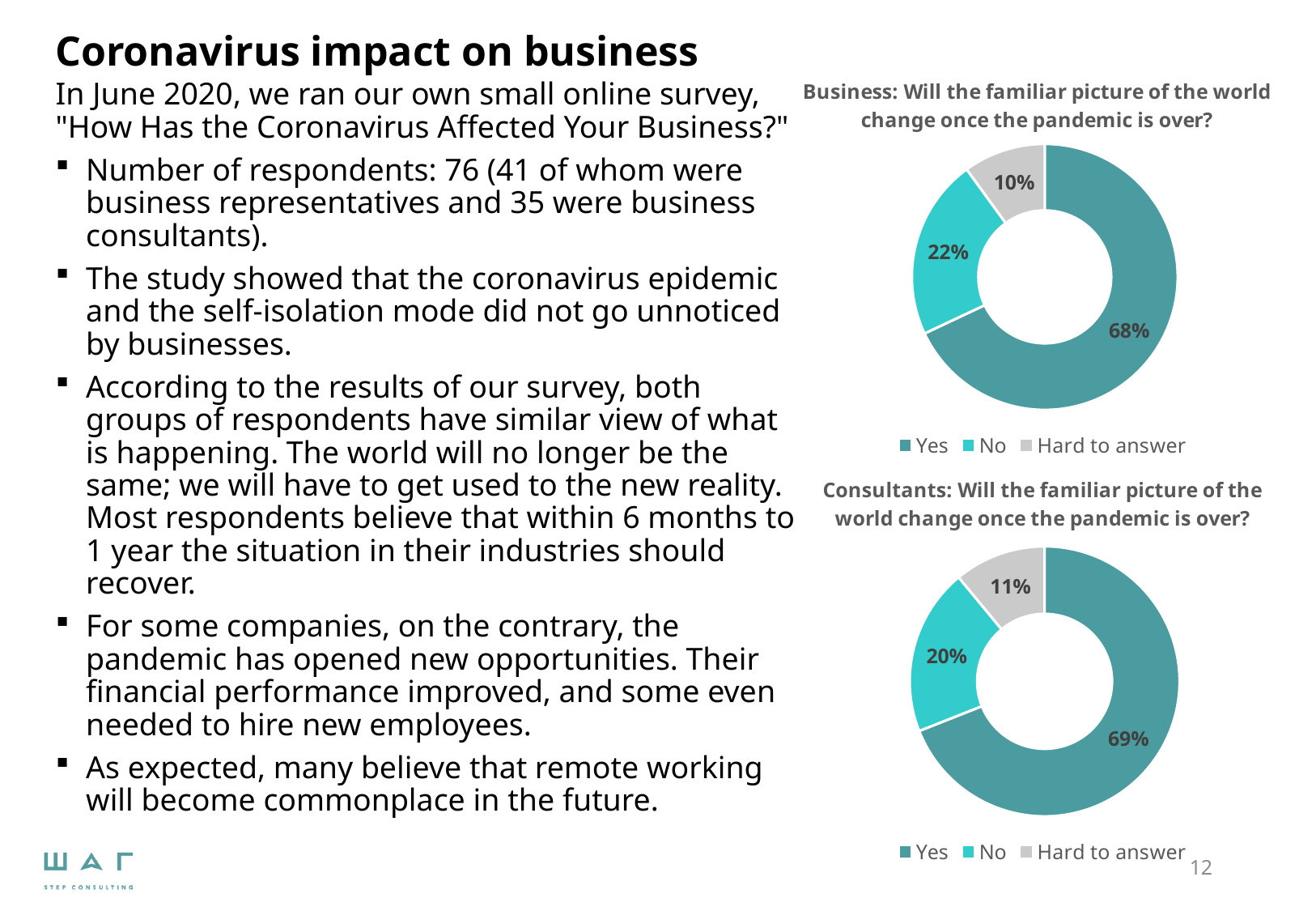
In the Consultants chart, what colour is the Hard to answer slice? Grey In the Business chart, which answer has the smallest share? Hard to answer In the Consultants chart, which answer has the largest share? Yes In the Business chart, what is the difference between the Yes share and the No share? 46% What is the title of the top chart on the slide? Business: Will the familiar picture of the world change once the pandemic is over? In the Business chart, what share of respondents found it hard to answer? 10% How many categories does the legend of the Business chart list? 3 Which is larger: the Yes share in the Business chart or the Yes share in the Consultants chart? Consultants In the Consultants chart, what share of respondents answered No? 20% In the Consultants chart, what is the difference between the No share and the Hard to answer share? 9% In the Business chart, what share of respondents answered Yes? 68% What kind of chart is the Consultants chart? Doughnut chart